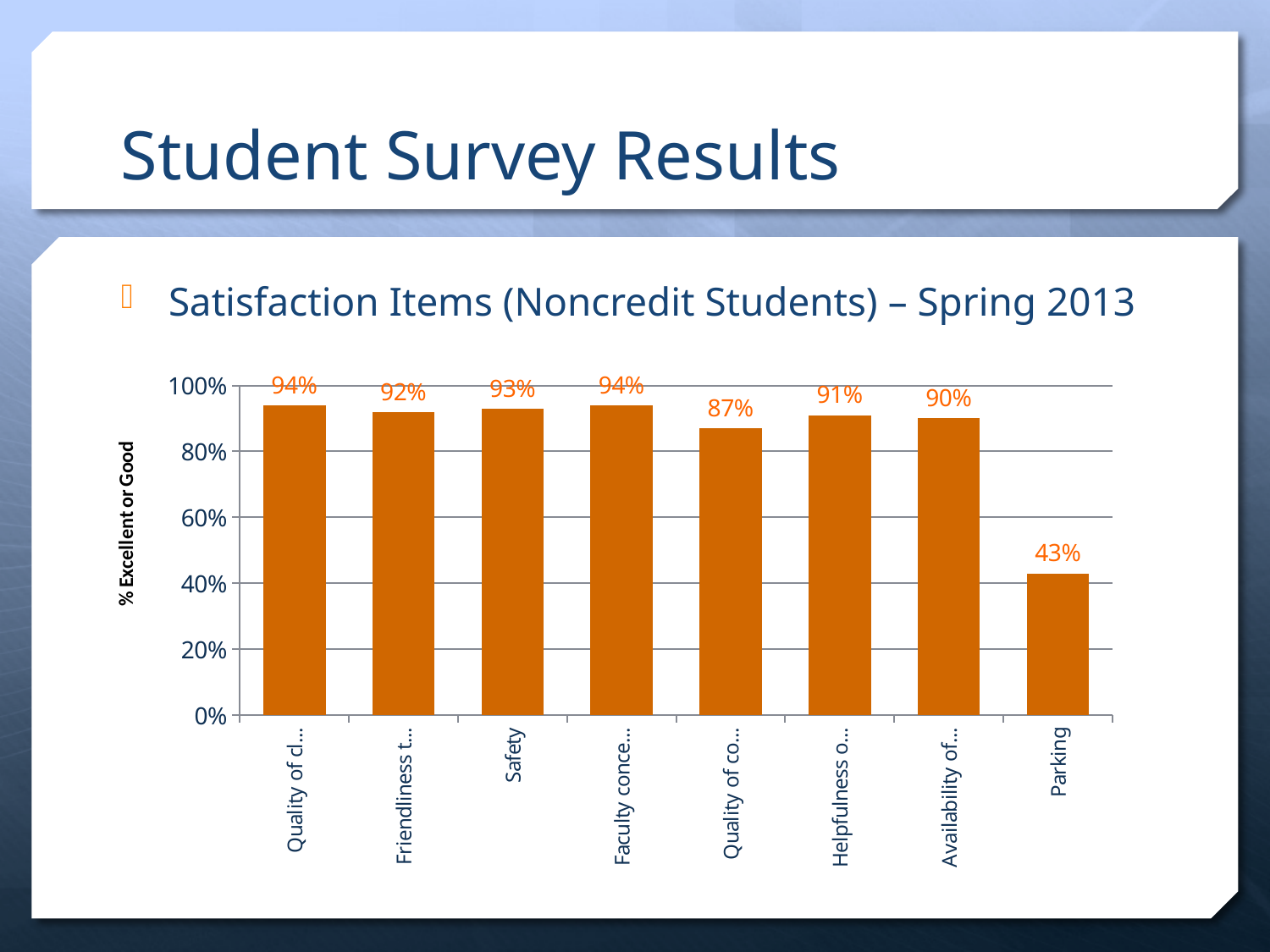
What is the difference between the values for Safety and Parking? 50% What is the highest value printed on the vertical axis? 100% Which category has the lowest value? Parking Is the value for Parking greater or less than 60%? less What is the value for Safety? 93% How many categories (bars) are shown in the chart? 8 Which is larger, the value for Safety or the value for Parking? Safety What is the value for Parking? 43% What kind of chart is shown on the slide? bar chart Is the value for Safety greater or less than 80%? greater How many bars have a value below 50%? 1 What is the label of the vertical axis? % Excellent or Good